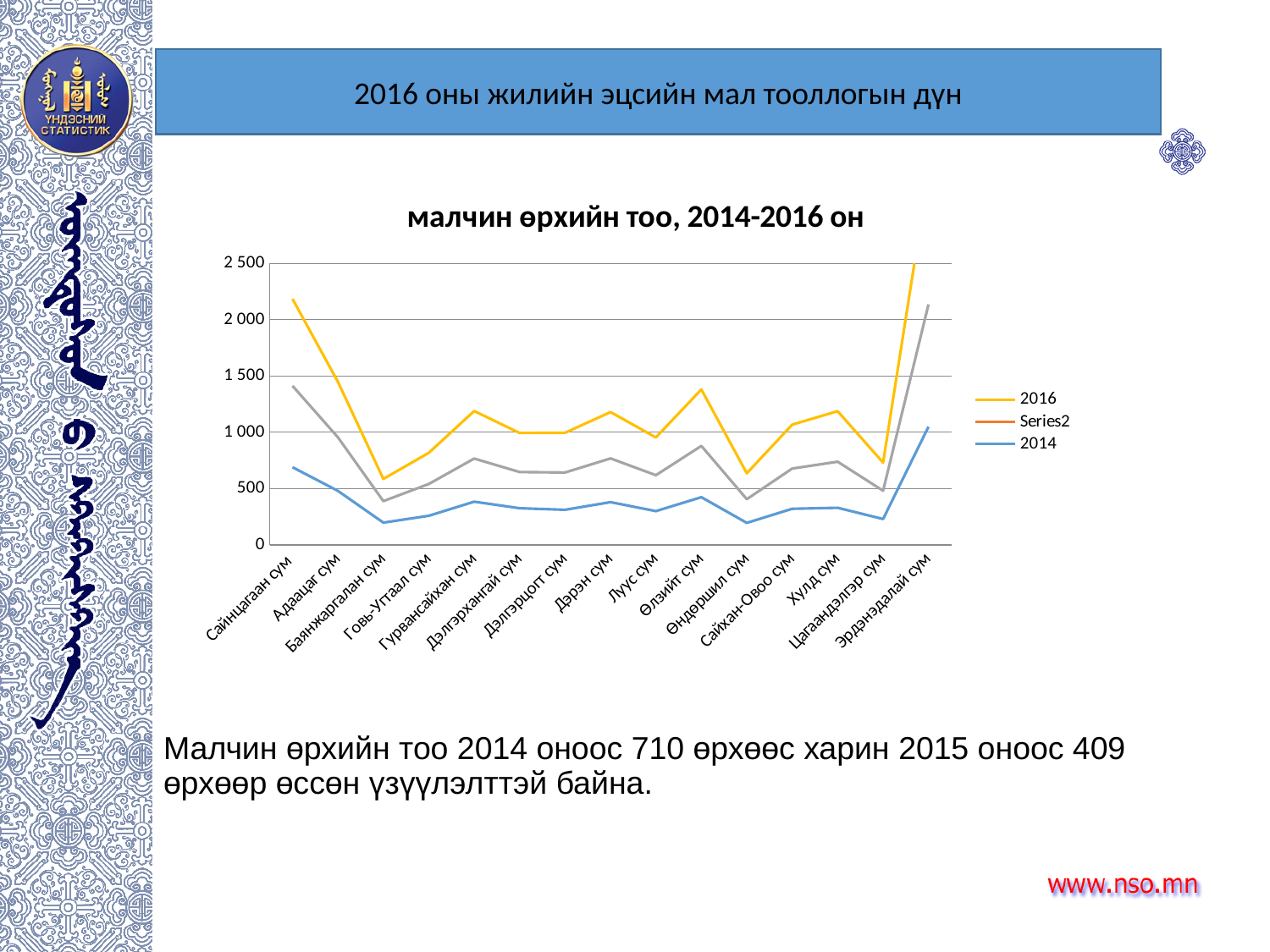
For the 2016 series, which sum has the highest value? Эрдэнэдалай сум For the 2014 series, which sum has the highest value? Эрдэнэдалай сум Is the 2014 value for Өлзийт сум greater or less than 500? less For Эрдэнэдалай сум, which series has the larger value, 2016 or 2014? 2016 How many series does the chart legend list? 3 Is the 2016 value for Сайнцагаан сум greater or less than 2 000? greater What is the title of the chart? малчин өрхийн тоо, 2014-2016 он Is the 2014 value for Сайнцагаан сум greater or less than 1 000? less How many sums (categories) are shown along the x axis of the chart? 15 Which entries are listed in the chart legend? 2016, Series2, 2014 What kind of chart is shown on the slide? line chart